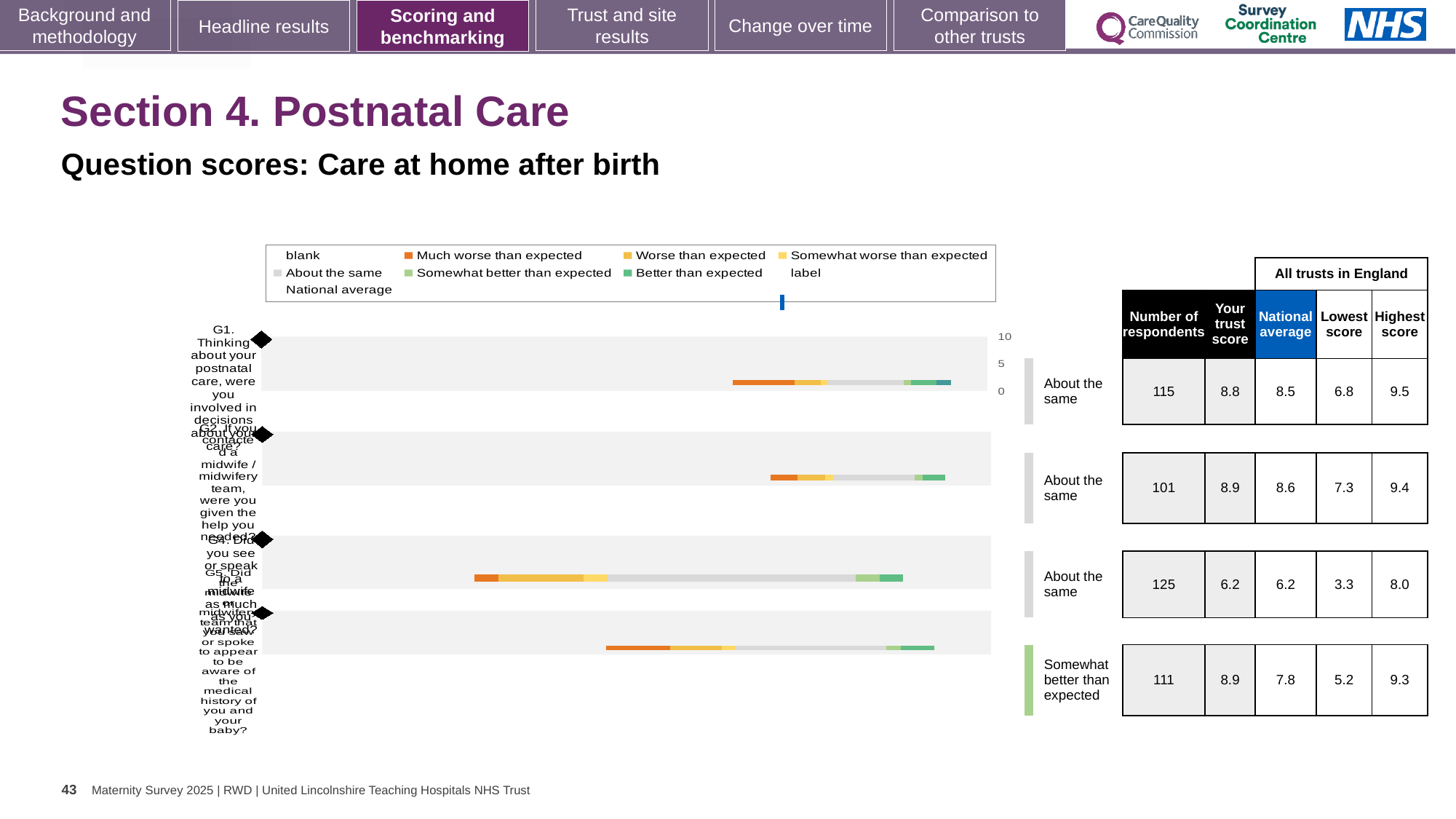
For the top bar, which is larger: the trust score or the national average? the trust score (8.8) For the bottom bar, what is the difference between the trust score (8.9) and the national average (7.8)? 1.1 What kind of chart is shown on the slide? bar chart How many question bars are plotted in the chart? 4 What is the number of respondents for the top bar (G1)? 115 Which bar is rated 'Somewhat better than expected'? the bottom (fourth) bar Which bar has the lowest 'Your trust score'? the third bar (6.2) What is the 'Your trust score' for the top bar (G1, involved in decisions about your care)? 8.8 What is the 'Your trust score' for the bottom bar? 8.9 For the third bar, what is the difference between the highest score (8.0) and the lowest score (3.3)? 4.7 Which bar has the highest number of respondents? the third bar (125) What is the national average for the top bar (G1)? 8.5